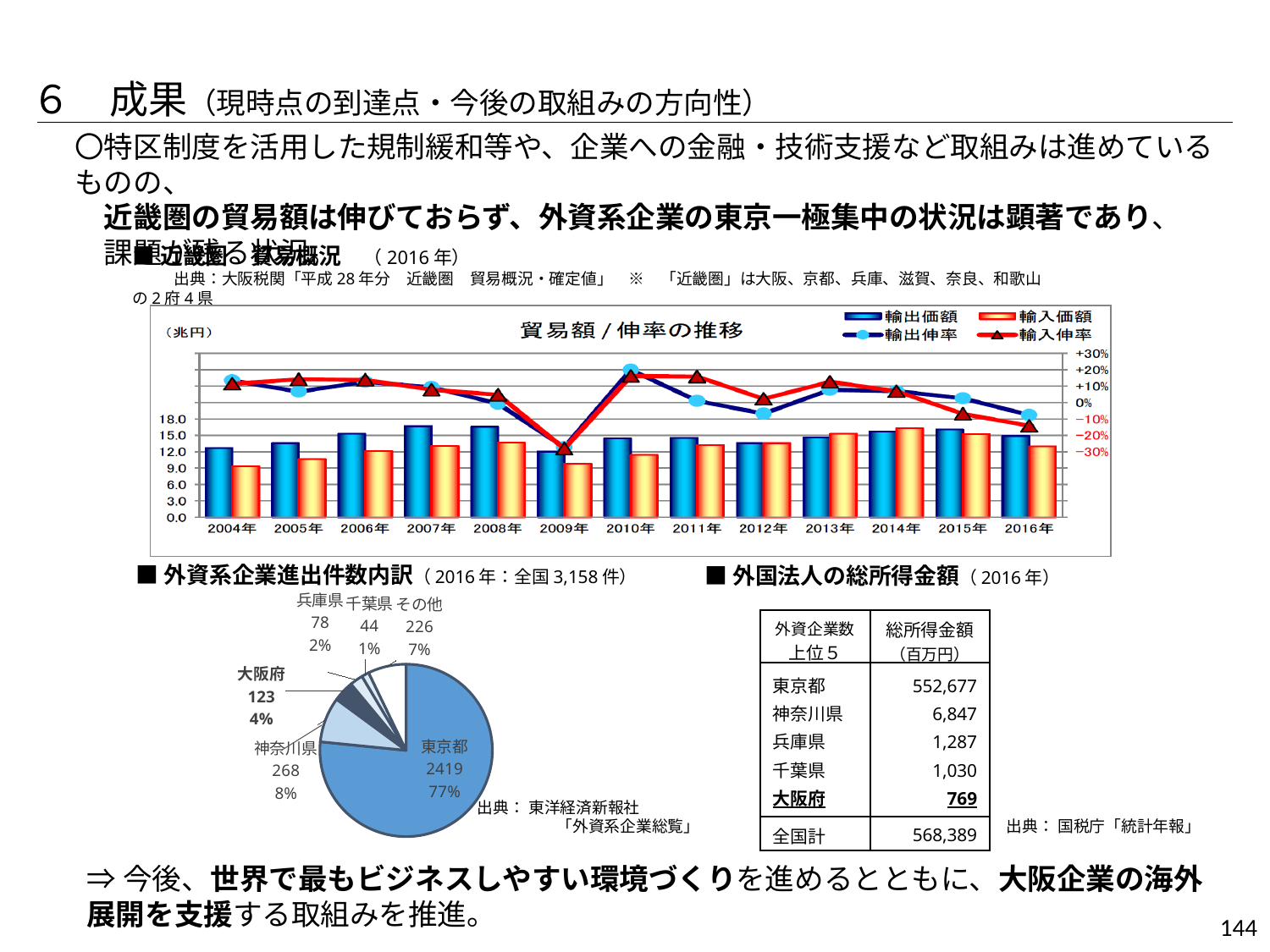
In the pie chart 外資系企業進出件数内訳, which prefecture has the smallest slice? 千葉県 In the pie chart 外資系企業進出件数内訳, how many slices are there? 6 In the chart 貿易額/伸率の推移, how many series does the legend list? 4 What kind of chart is 外資系企業進出件数内訳? Pie chart In the pie chart 外資系企業進出件数内訳, which category has the largest slice? 東京都 In the pie chart 外資系企業進出件数内訳, what share of the pie does 神奈川県 hold? 8% In the chart 貿易額/伸率の推移, is the 輸入価額 bar for 2004年 greater or less than 12.0? less In the pie chart 外資系企業進出件数内訳, what is the value for 大阪府? 123 In the chart 貿易額/伸率の推移, is the 輸出価額 bar for 2007年 greater or less than 15.0? greater In the pie chart 外資系企業進出件数内訳, how many cases are shown for 東京都? 2419 In the pie chart 外資系企業進出件数内訳, what is the difference between the values for 東京都 and 神奈川県? 2151 In the chart 貿易額/伸率の推移, how many years are shown on the x axis? 13